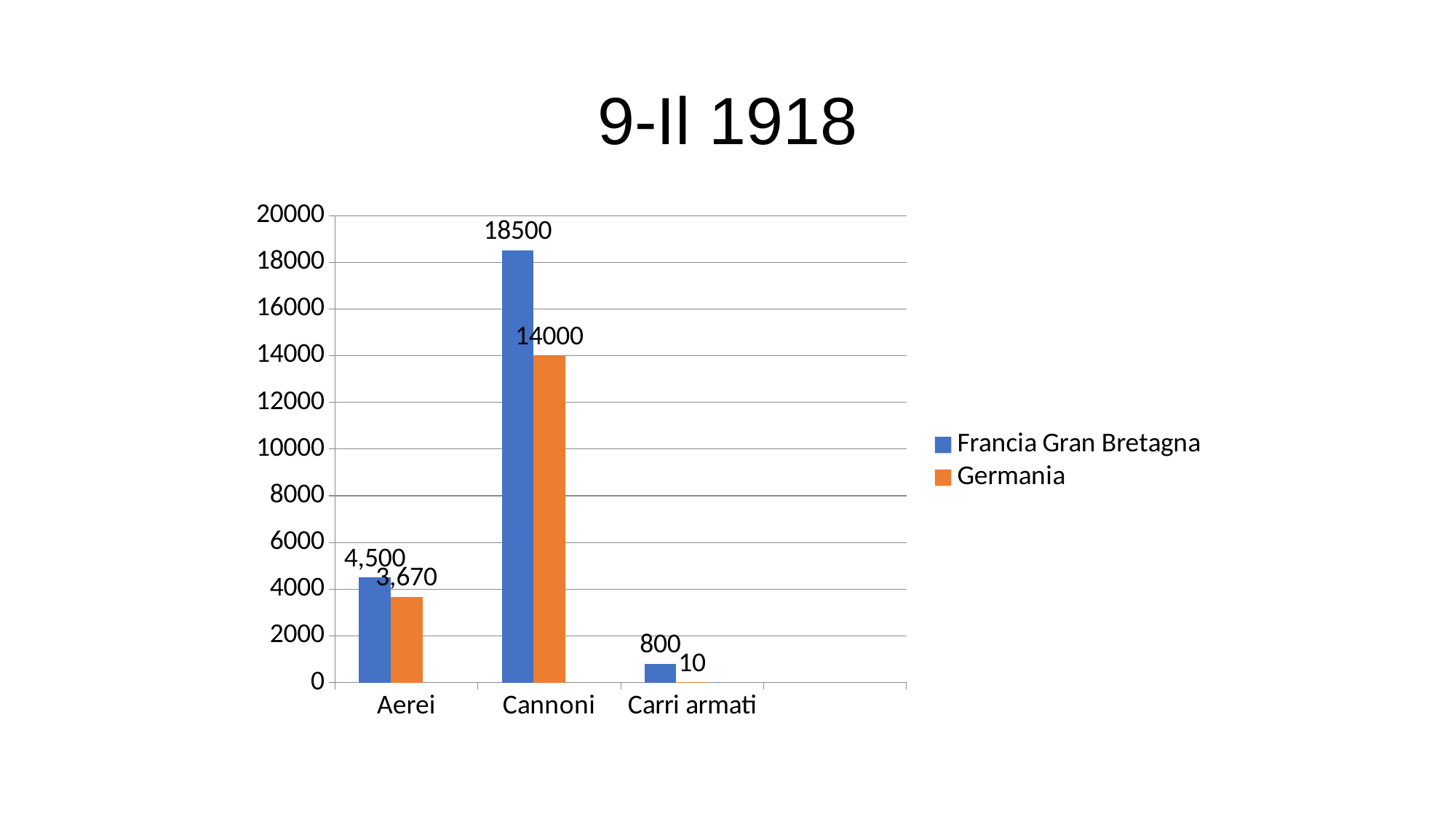
What is the value for Francia Gran Bretagna in the Cannoni category? 18500 How many categories are shown on the x axis? 3 What is the title of the chart? 9-II 1918 Which category has the highest value for Francia Gran Bretagna? Cannoni What is the value for Germania in the Aerei category? 3,670 What is the difference between Francia Gran Bretagna and Germania in the Cannoni category? 4500 What is the value for Francia Gran Bretagna in the Aerei category? 4,500 What kind of chart is shown on the slide? Bar chart What is the value for Germania in the Carri armati category? 10 Which is larger in the Carri armati category, Francia Gran Bretagna or Germania? Francia Gran Bretagna Which category has the lowest value for Germania? Carri armati How many series does the legend list? 2